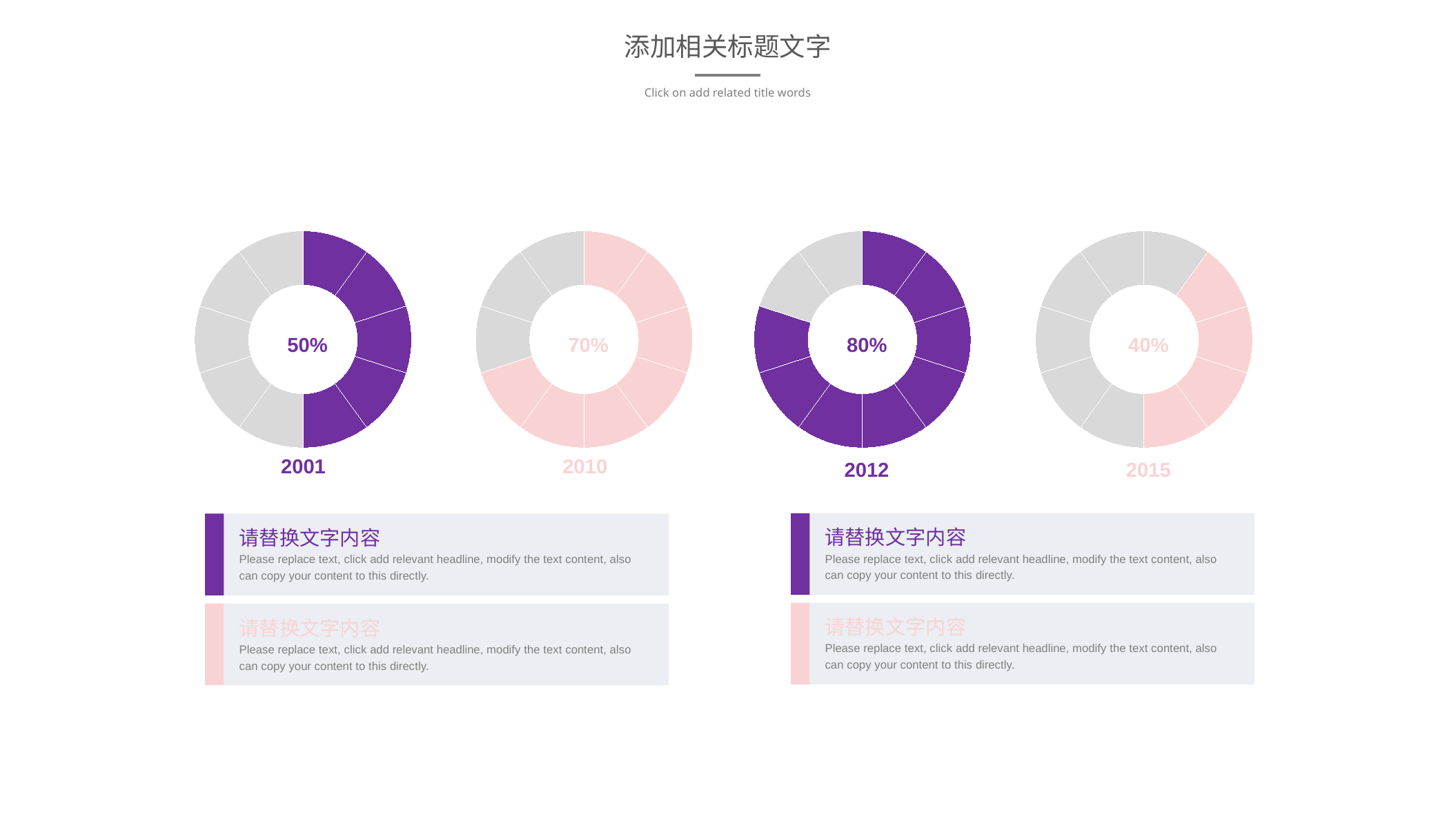
Which year's donut chart shows the lowest percentage? 2015 What percentage is shown in the donut chart labelled 2010? 70% What kind of charts are shown on the slide? Donut (pie) charts Do the percentages rise or fall across the donut charts from 2001 to 2012? Rise Which year's donut chart shows the highest percentage? 2012 What percentage is shown in the donut chart labelled 2001? 50% How many donut charts are on the slide? 4 What percentage is shown in the donut chart labelled 2015? 40% Which is larger, the percentage shown for 2010 or the percentage shown for 2015? 2010 What colour is the filled portion of the donut chart labelled 2012? Purple What percentage is shown in the donut chart labelled 2012? 80% What is the difference between the percentage shown for 2012 and the percentage shown for 2001? 30 percentage points